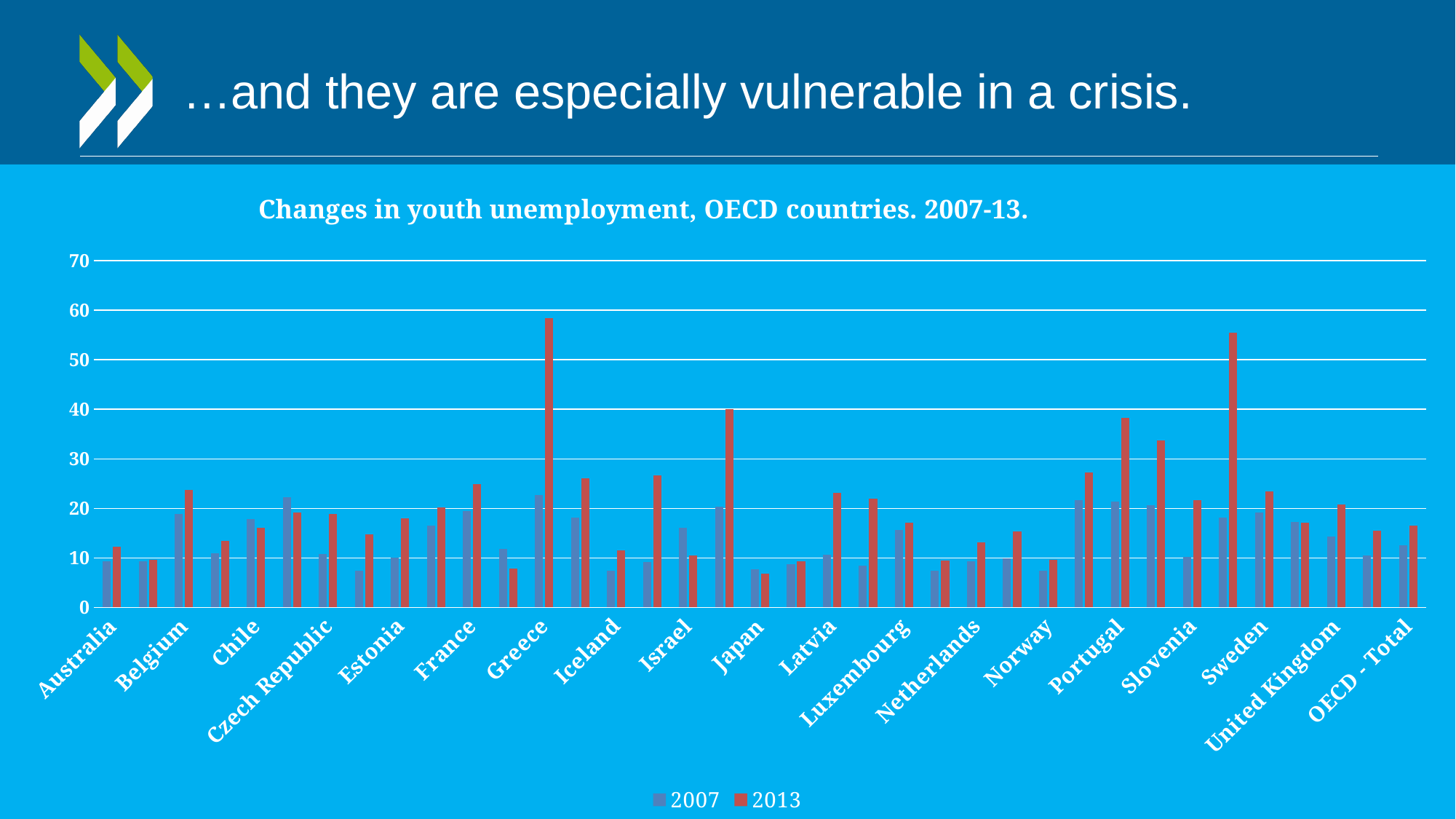
What kind of chart is shown on the slide? bar chart Is the 2007 value for Czech Republic greater or less than 20? less Is the 2013 value for Greece greater or less than 50? greater Which is larger: the 2013 value for Greece or the 2013 value for Portugal? Greece Which colour represents the 2013 series in the chart? red How many series does the legend list? 2 Which labelled country has the highest 2013 value? Greece Is the 2013 value for Japan greater or less than 10? less What is the title of the chart? Changes in youth unemployment, OECD countries. 2007-13. For Greece, which is larger: the 2007 value or the 2013 value? 2013